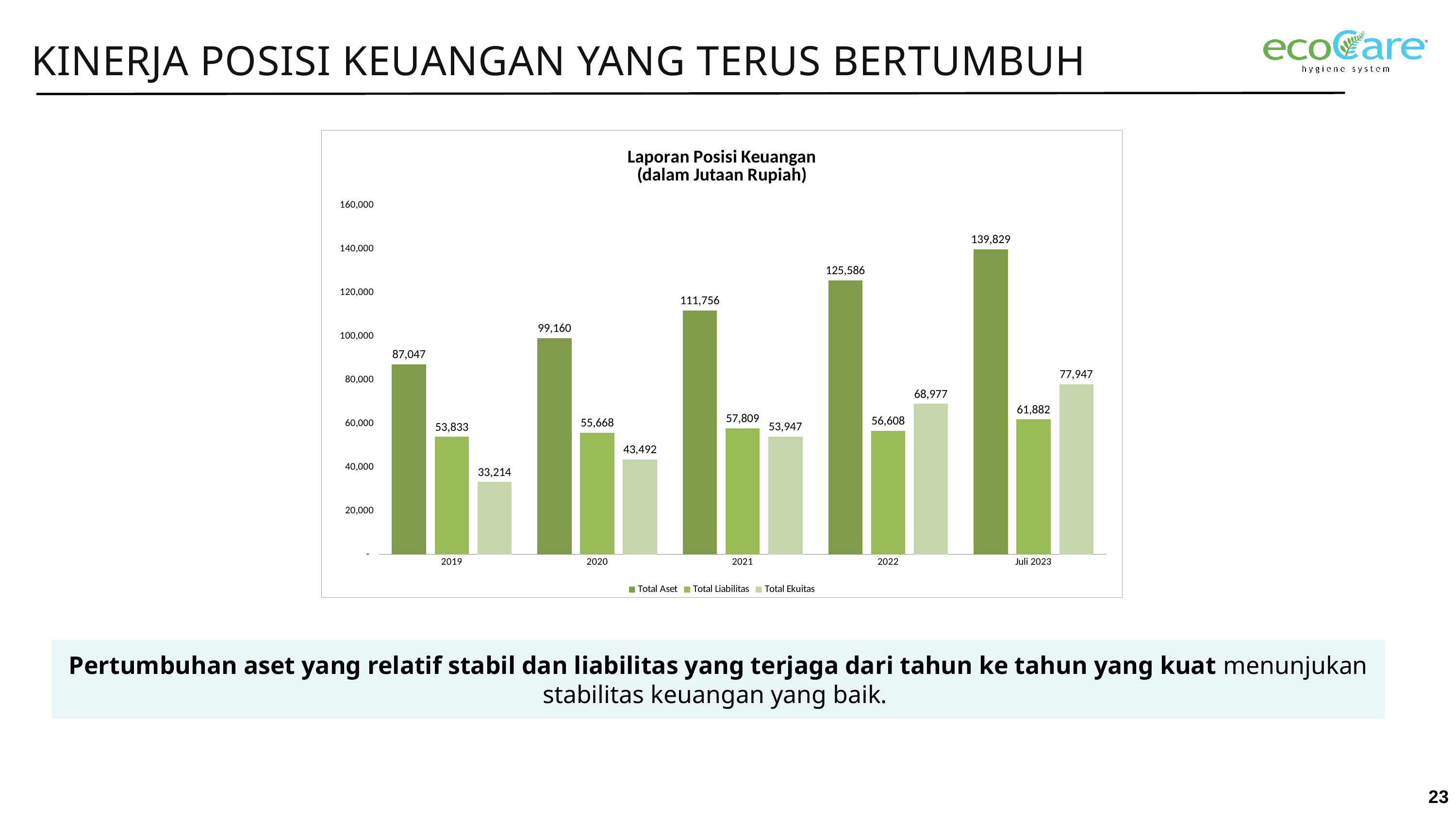
What is the value of Total Ekuitas for 2019? 33,214 What is the value of Total Liabilitas for Juli 2023? 61,882 What kind of chart is shown on the slide? Bar chart Which period has the lowest Total Ekuitas? 2019 Does Total Aset rise or fall from 2019 to Juli 2023? Rise Which is larger in 2020: Total Liabilitas or Total Ekuitas? Total Liabilitas How many periods are shown on the x axis? 5 What is the value of Total Aset for 2021? 111,756 Which period has the highest Total Aset? Juli 2023 What is the title of the chart? Laporan Posisi Keuangan (dalam Jutaan Rupiah) How many series does the legend list? 3 What is the difference between Total Aset and Total Liabilitas in 2022? 68,978